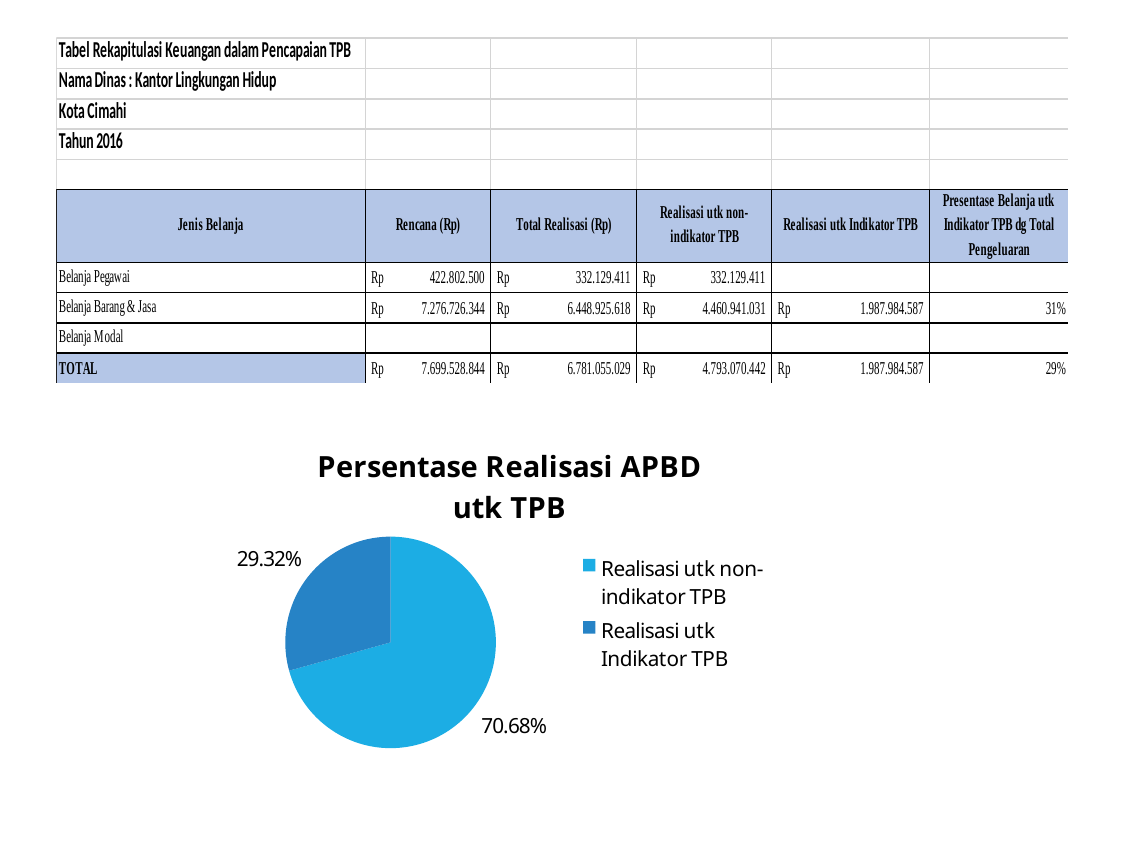
How many entries does the pie chart's legend list? 2 Which legend entry in the pie chart is shown in the darker blue colour? Realisasi utk Indikator TPB What kind of chart is shown on the slide? Pie chart How many slices does the pie chart have? 2 What is the title of the pie chart? Persentase Realisasi APBD utk TPB What is the difference in percentage points between the Realisasi utk non-indikator TPB slice and the Realisasi utk Indikator TPB slice? 41.36 What share of the pie does the Realisasi utk Indikator TPB slice represent? 29.32% Which is larger in the pie chart: Realisasi utk Indikator TPB or Realisasi utk non-indikator TPB? Realisasi utk non-indikator TPB Which slice of the pie chart is the largest? Realisasi utk non-indikator TPB What percentage does the pie chart show for Realisasi utk Indikator TPB? 29.32% What percentage does the pie chart show for Realisasi utk non-indikator TPB? 70.68% Which slice of the pie chart is the smallest? Realisasi utk Indikator TPB